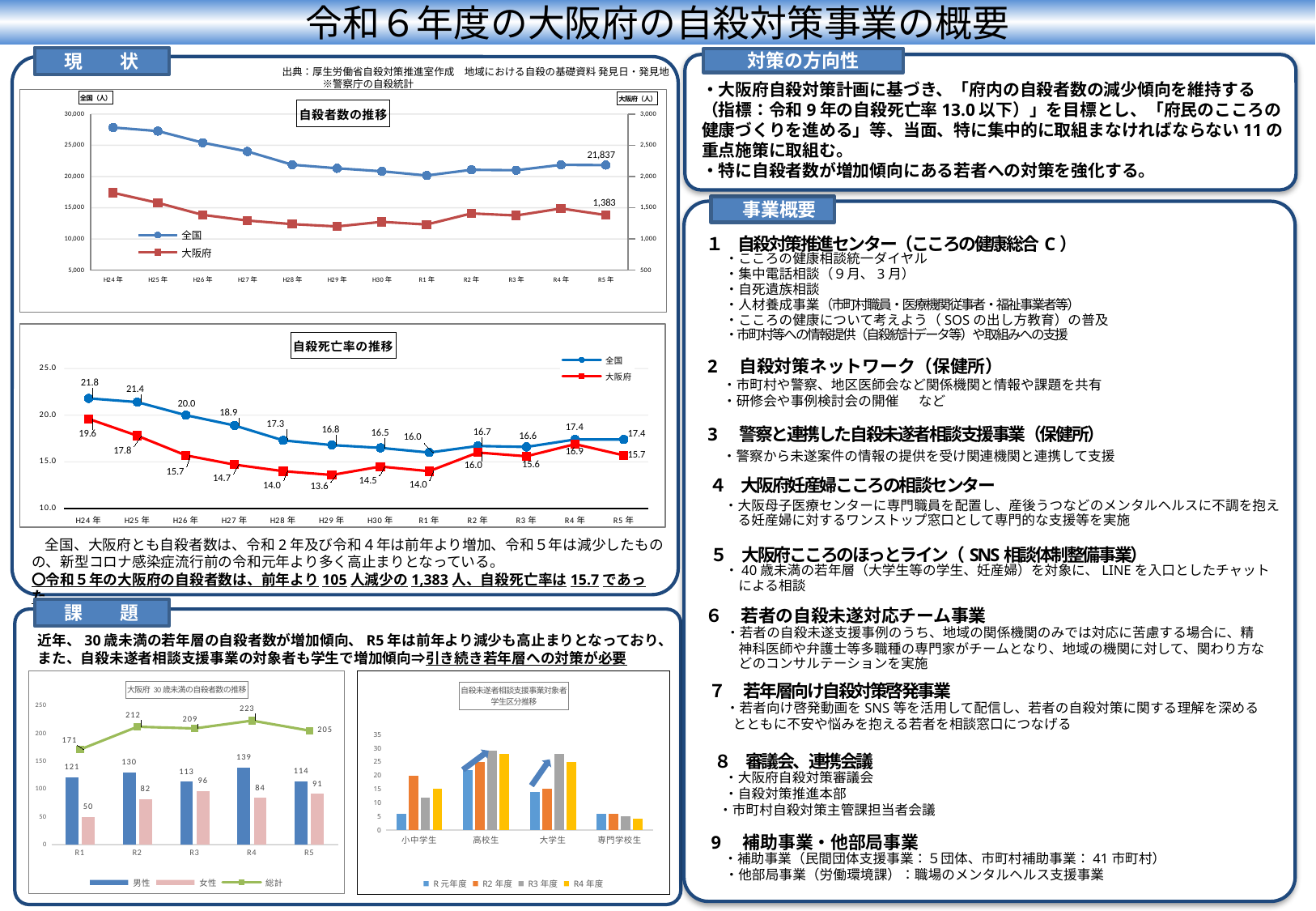
In the 大阪府30歳未満の自殺者数の推移 chart, which is larger at R3, 男性 or 女性? 男性 In the 大阪府30歳未満の自殺者数の推移 chart, which year has the highest 男性 value? R4 In the 自殺死亡率の推移 chart, what is the 大阪府 value at H29年? 13.6 In the 自殺死亡率の推移 chart, how many years are shown on the x axis? 12 In the 大阪府30歳未満の自殺者数の推移 chart, what is the 総計 value for R4? 223 In the 自殺者数の推移 chart, how many series does the legend list? 2 In the 自殺死亡率の推移 chart, what is the difference between the 全国 and 大阪府 values at R5年? 1.7 In the 自殺死亡率の推移 chart, which year has the lowest 大阪府 value? H29年 In the 自殺者数の推移 chart, what is the value labelled for 全国 at R5年? 21,837 In the 自殺未遂者相談支援事業対象者学生区分推移 chart, is the R元年度 value for 小中学生 greater or less than 10? less In the 自殺者数の推移 chart, what is the value labelled for 大阪府 at R5年? 1,383 In the 自殺未遂者相談支援事業対象者学生区分推移 chart, how many series does the legend list? 4